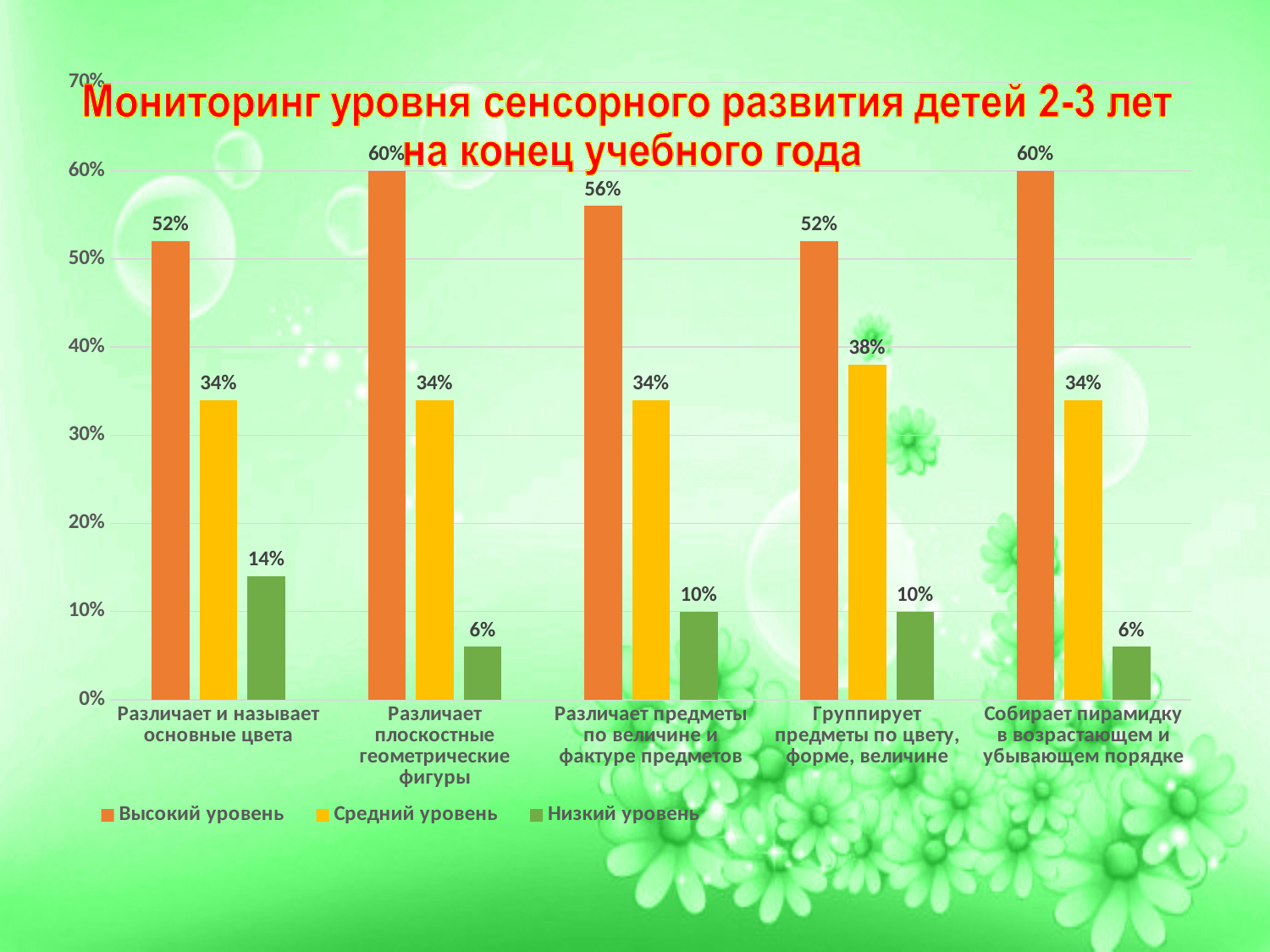
Which category has the highest value for "Низкий уровень"? Различает и называет основные цвета How many series does the legend list? 3 How many categories are shown on the x axis? 5 What is the difference between "Высокий уровень" and "Средний уровень" for "Различает плоскостные геометрические фигуры"? 26% Which category has the highest value for "Средний уровень"? Группирует предметы по цвету, форме, величине What is the value of "Низкий уровень" for "Различает и называет основные цвета"? 14% What is the title of the chart? Мониторинг уровня сенсорного развития детей 2-3 лет на конец учебного года What type of chart is shown on the slide? Bar chart Which is larger: "Высокий уровень" for "Различает и называет основные цвета" or "Высокий уровень" for "Собирает пирамидку в возрастающем и убывающем порядке"? Собирает пирамидку в возрастающем и убывающем порядке What is the value of "Высокий уровень" for "Различает предметы по величине и фактуре предметов"? 56% What is the value of "Средний уровень" for "Группирует предметы по цвету, форме, величине"? 38% Is the value of "Низкий уровень" for "Собирает пирамидку в возрастающем и убывающем порядке" greater or less than 10%? less